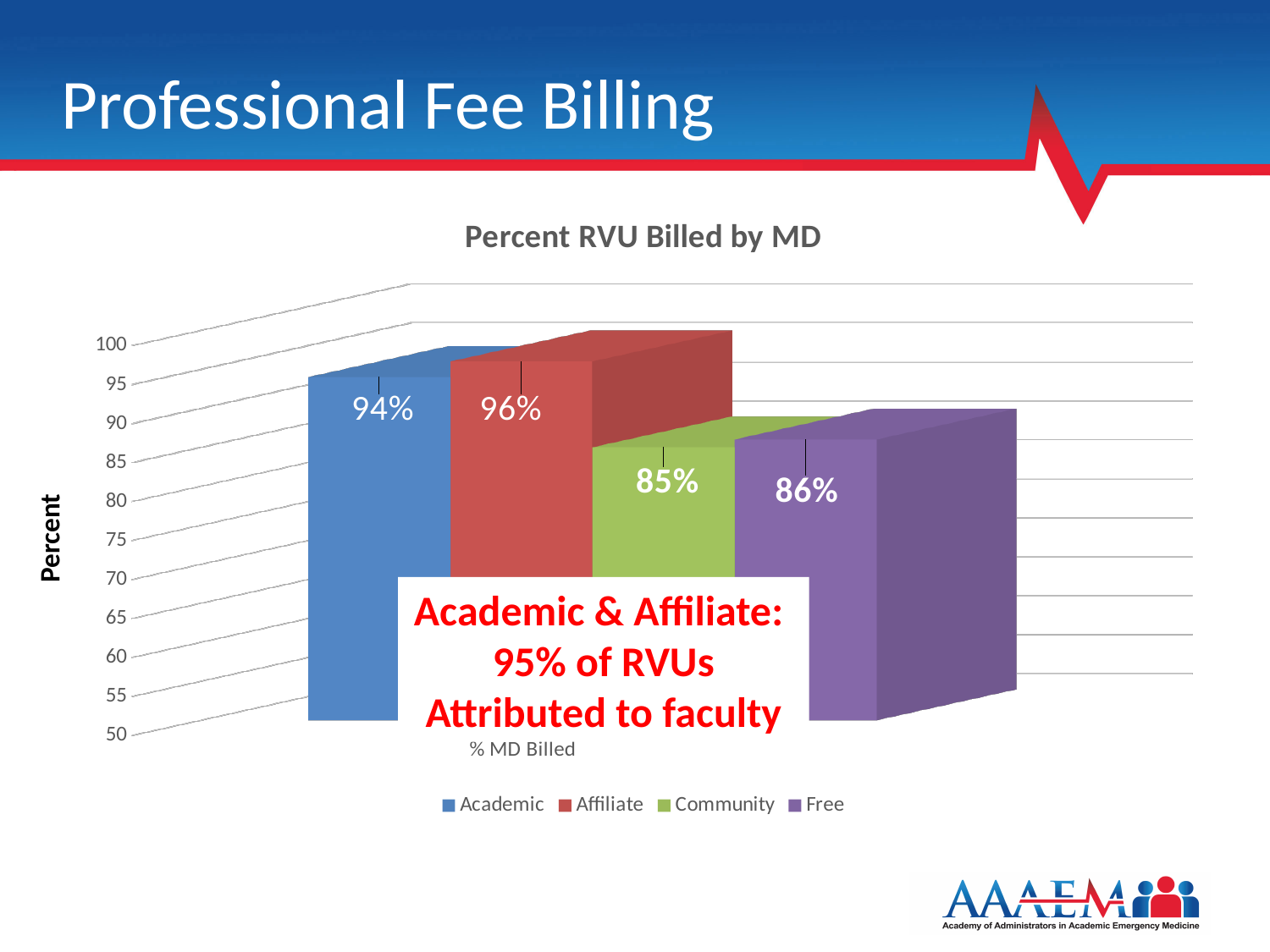
Which series has the highest value in the Percent RVU Billed by MD chart? Affiliate What is the difference between the Affiliate and Community values in the Percent RVU Billed by MD chart? 11% What is the value for Academic in the Percent RVU Billed by MD chart? 94% Which is larger in the Percent RVU Billed by MD chart, Academic or Free? Academic How many series does the legend list in the Percent RVU Billed by MD chart? 4 What is the value for Affiliate in the Percent RVU Billed by MD chart? 96% What is the value for Free in the Percent RVU Billed by MD chart? 86% What is the title of the chart on the slide? Percent RVU Billed by MD What is the value for Community in the Percent RVU Billed by MD chart? 85% Which series has the lowest value in the Percent RVU Billed by MD chart? Community What is the label on the vertical axis of the chart? Percent What kind of chart is shown on the slide? Bar chart